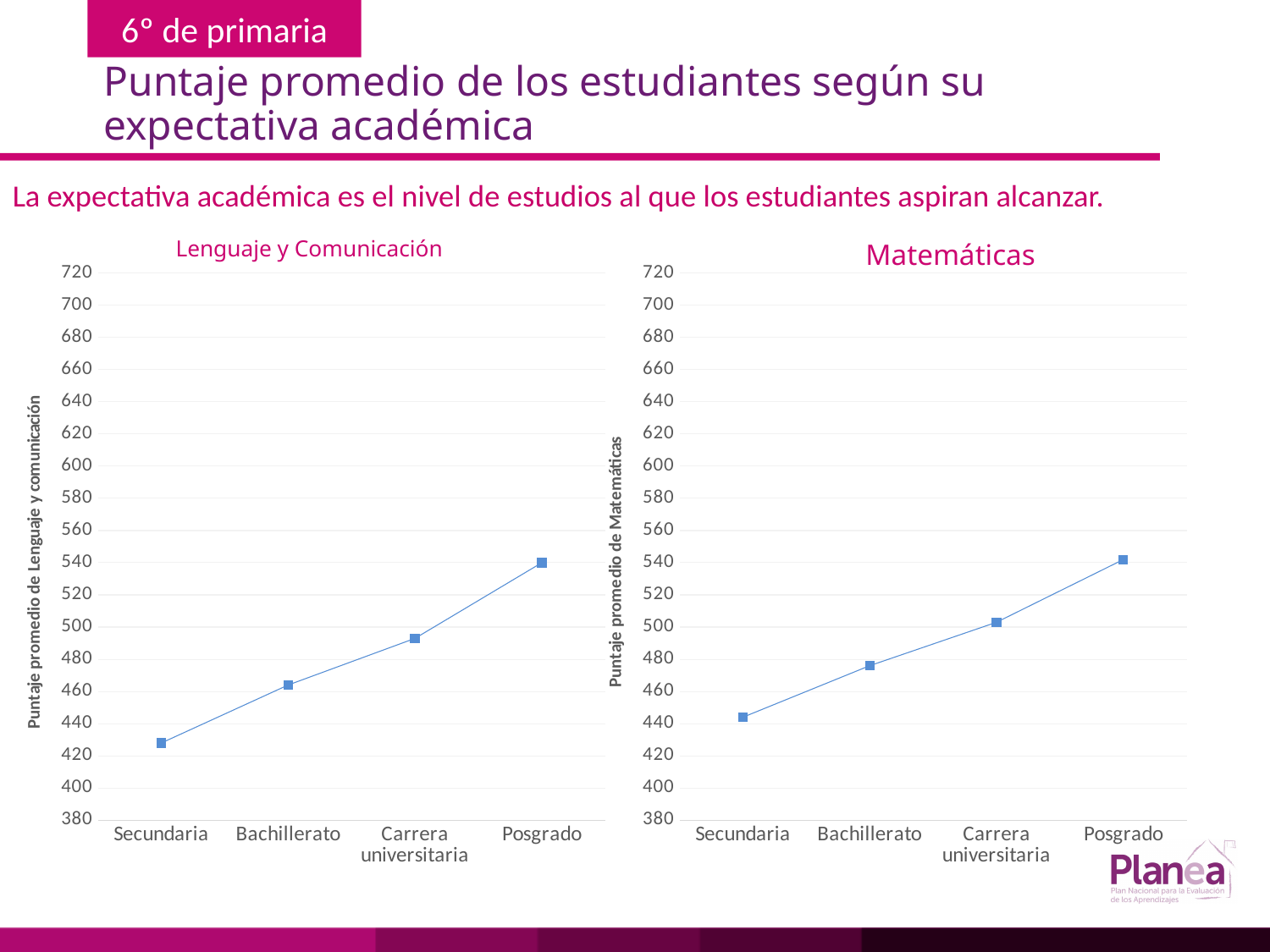
In the Lenguaje y Comunicación chart, do the values rise or fall from Secundaria to Posgrado? rise In the Matemáticas chart, which category has the lowest score? Secundaria In the Lenguaje y Comunicación chart, is the value for Bachillerato greater or less than 480? less In the Matemáticas chart, which is larger, the value for Bachillerato or the value for Carrera universitaria? Carrera universitaria In the Lenguaje y Comunicación chart, is the value for Posgrado greater or less than 520? greater In the Matemáticas chart, is the value for Secundaria greater or less than 460? less What kind of chart is the Lenguaje y Comunicación chart? line chart What is the y-axis label of the Lenguaje y Comunicación chart? Puntaje promedio de Lenguaje y comunicación In the Lenguaje y Comunicación chart, which category has the highest score? Posgrado How many categories are shown on the x axis of the Matemáticas chart? 4 What is the title of the chart on the right side of the slide? Matemáticas